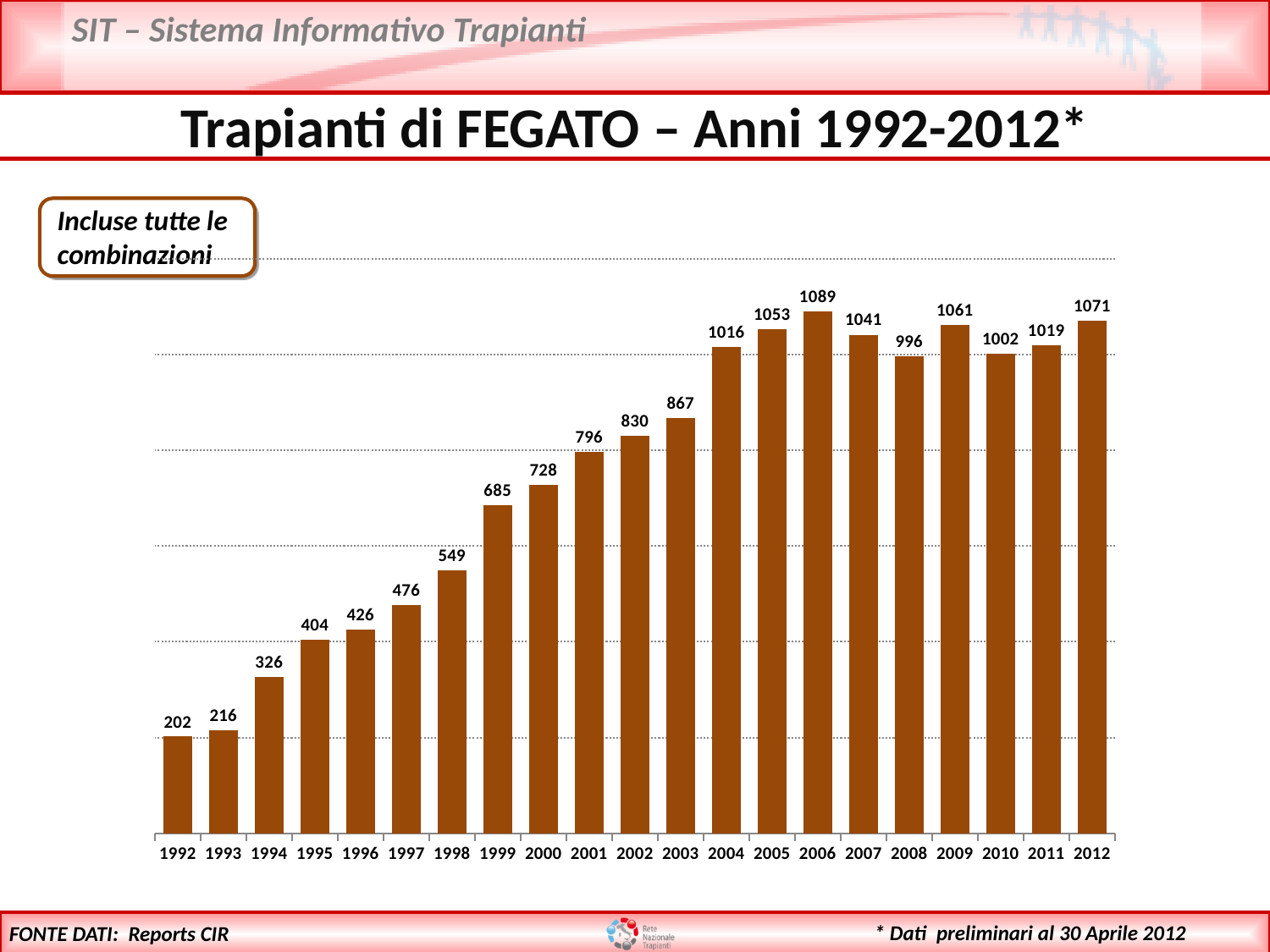
What kind of chart is this? bar chart How many years are shown on the x axis? 21 What is the value for 1999? 685 What is the difference between the values for 2012 and 1992? 869 Which is larger, the value for 2008 or the value for 2010? 2010 What is the value for 2006? 1089 What is the title of the chart? Trapianti di FEGATO – Anni 1992-2012* What is the value for 1992? 202 Do the values generally rise or fall from 1992 to 2004? rise Which year has the highest value? 2006 What is the difference between the values for 2006 and 2005? 36 Which year has the lowest value? 1992